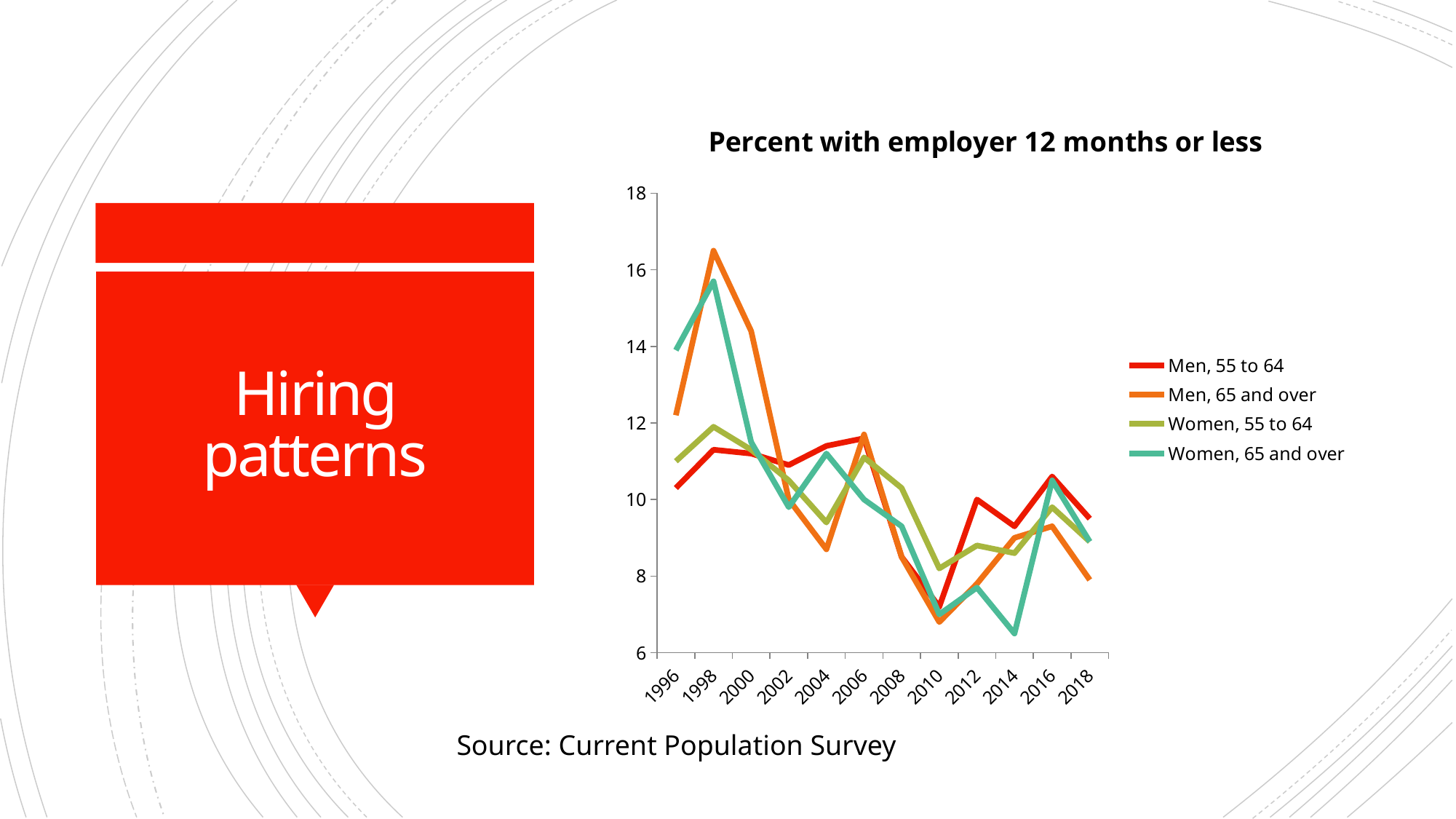
What kind of chart is shown on the slide? line chart Is the value for Women, 65 and over in 2014 greater or less than 8? less Which series has the highest value in 1998? Men, 65 and over How many series does the legend list? 4 Does the value for Men, 65 and over rise or fall from 1998 to 2010? fall Which series has the lowest value in 2014? Women, 65 and over What is the title of the chart? Percent with employer 12 months or less Is the value for Men, 65 and over in 1998 greater or less than 16? greater In 2018, which is larger: the value for Men, 55 to 64 or the value for Men, 65 and over? Men, 55 to 64 Is the value for Men, 55 to 64 in 1996 greater or less than 12? less Which series is shown in orange in the legend? Men, 65 and over How many years are plotted along the x axis? 12